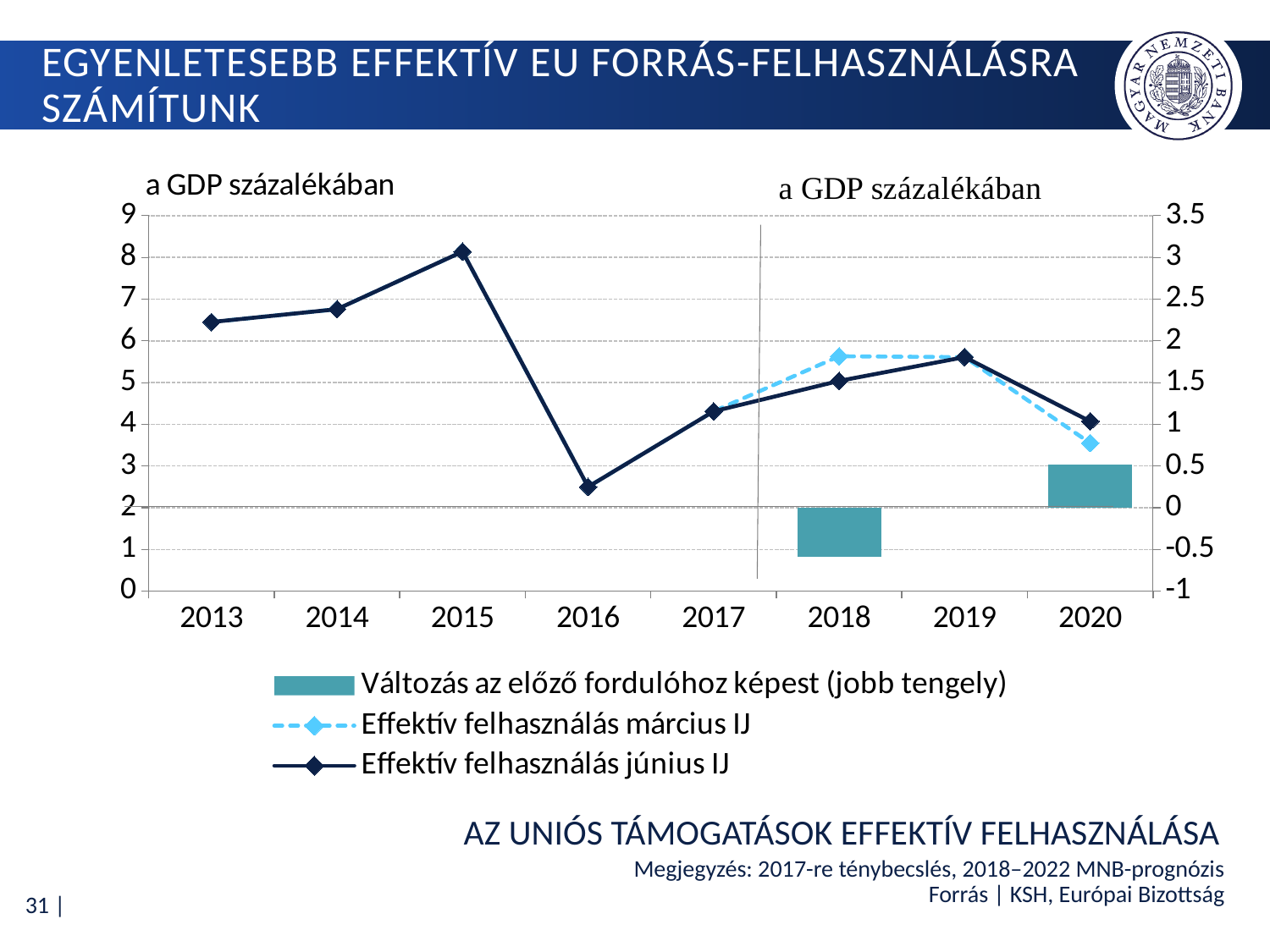
How many series does the legend list? 3 In 2018, which line is higher: 'Effektív felhasználás március IJ' or 'Effektív felhasználás június IJ'? Effektív felhasználás március IJ What kind of chart is shown on the slide? A combined line and bar chart How many years are shown on the x axis? 8 In which year does the 'Effektív felhasználás június IJ' line reach its highest value? 2015 Is the value of the 'Effektív felhasználás június IJ' line in 2015 greater or less than 8? greater Is the bar for 'Változás az előző fordulóhoz képest' in 2018 positive or negative on the right axis? Negative In which year does the 'Effektív felhasználás június IJ' line reach its lowest value? 2016 Does the 'Effektív felhasználás június IJ' line rise or fall from 2013 to 2015? Rise What is the title of the chart shown below the plot? AZ UNIÓS TÁMOGATÁSOK EFFEKTÍV FELHASZNÁLÁSA Is the value of the 'Effektív felhasználás március IJ' line in 2020 greater or less than 4? less